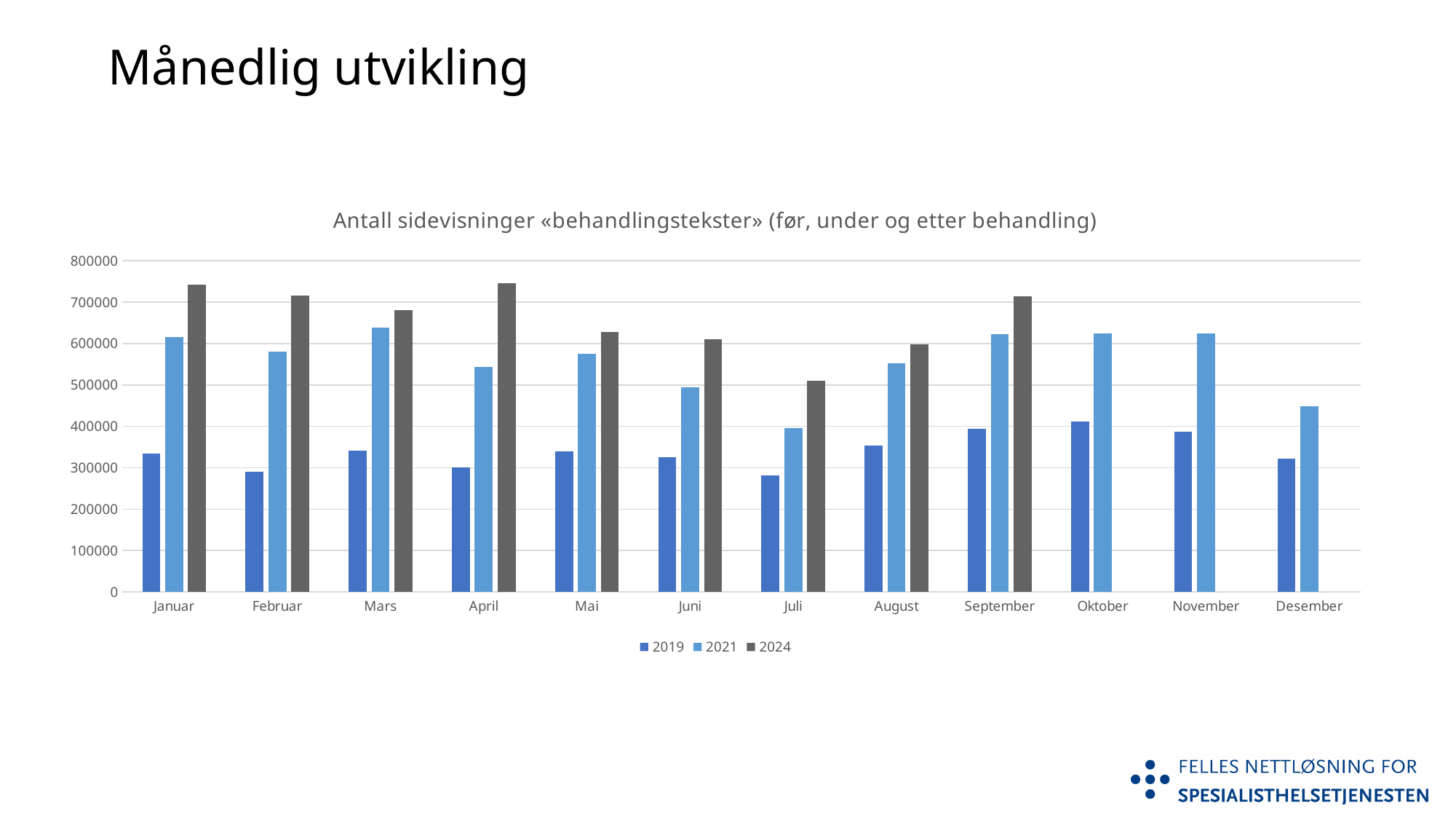
Is the value for 2024 in Januar greater or less than 700000? greater How many months are shown on the x axis? 12 How many series does the legend list? 3 Is the value for 2021 in Desember greater or less than 500000? less What kind of chart is shown on the slide? Bar chart In which month is the 2024 value lowest? Juli Which years are listed in the legend? 2019, 2021, 2024 What is the title of the chart? Antall sidevisninger «behandlingstekster» (før, under og etter behandling) In which month is the 2021 value lowest? Juli In Januar, which is larger: the 2021 value or the 2024 value? 2024